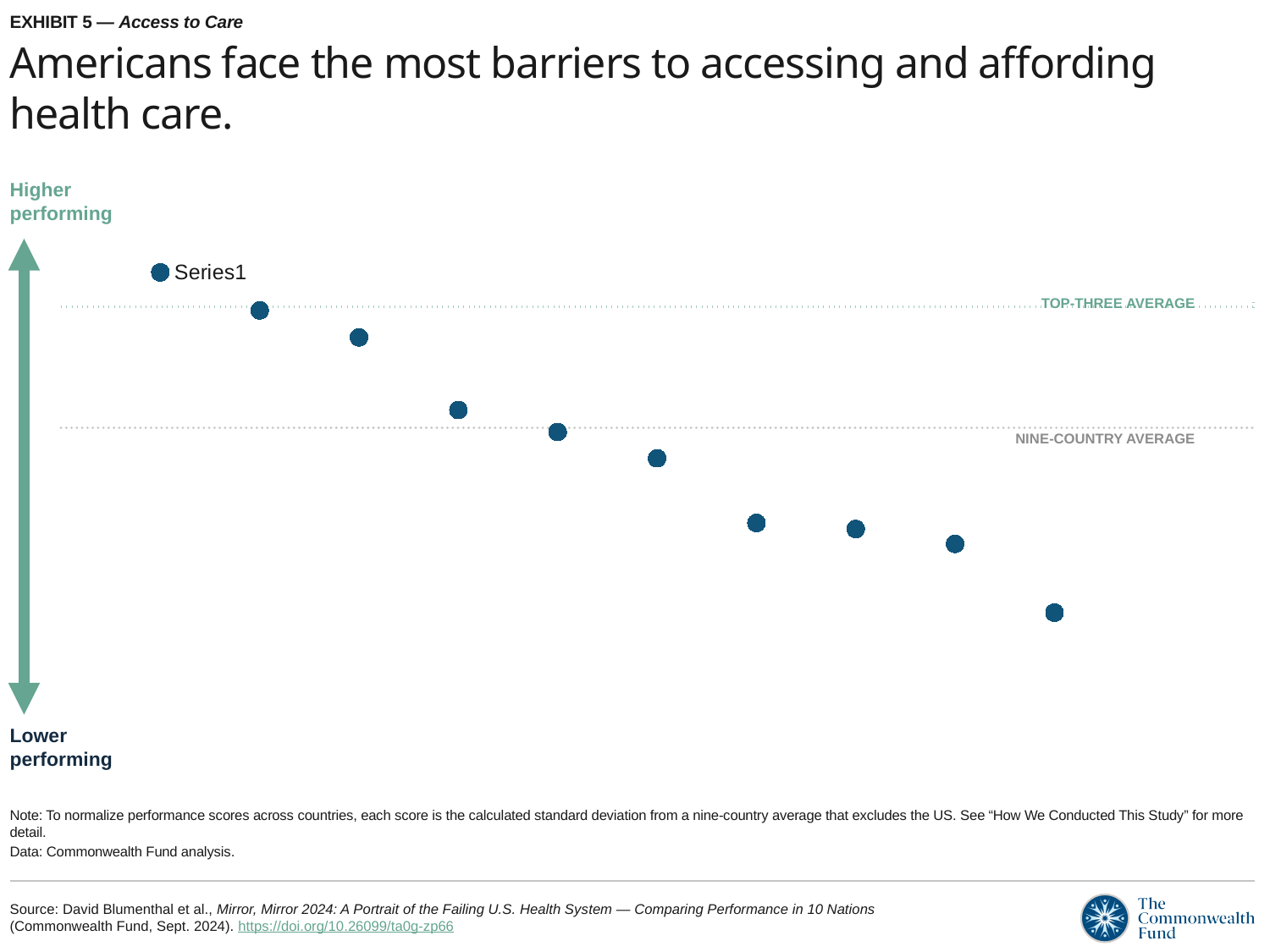
What are the two dotted reference lines on the chart labeled? TOP-THREE AVERAGE and NINE-COUNTRY AVERAGE Is the rightmost plotted point above or below the NINE-COUNTRY AVERAGE line? below Which plotted point is lower: the leftmost point or the rightmost point? rightmost What kind of chart is shown on the slide? scatter chart Do the plotted values rise or fall moving from left to right across the chart? fall Is the second point from the left above or below the NINE-COUNTRY AVERAGE line? above